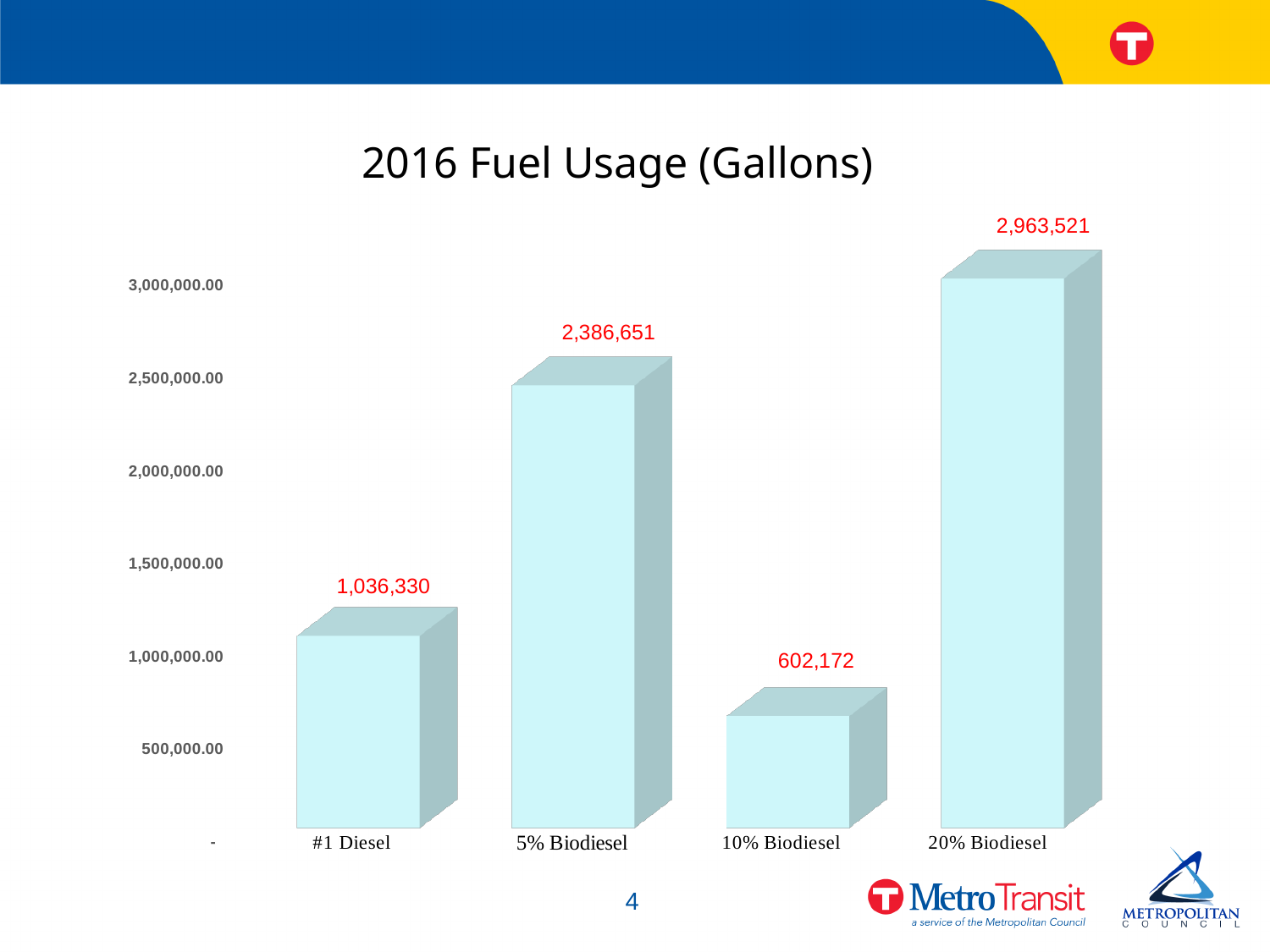
What is the value for 20% Biodiesel? 2,963,521 Which is larger, the value for #1 Diesel or the value for 5% Biodiesel? 5% Biodiesel Which fuel type has the lowest usage? 10% Biodiesel What is the difference between the values for 20% Biodiesel and 5% Biodiesel? 576,870 Is the value for 10% Biodiesel greater or less than 1,000,000? less What is the value for 10% Biodiesel? 602,172 What kind of chart is shown on the slide? bar chart Which fuel type has the highest usage? 20% Biodiesel What is the difference between the values for #1 Diesel and 10% Biodiesel? 434,158 What is the value for #1 Diesel? 1,036,330 How many fuel categories are shown in the chart? 4 What is the value for 5% Biodiesel? 2,386,651